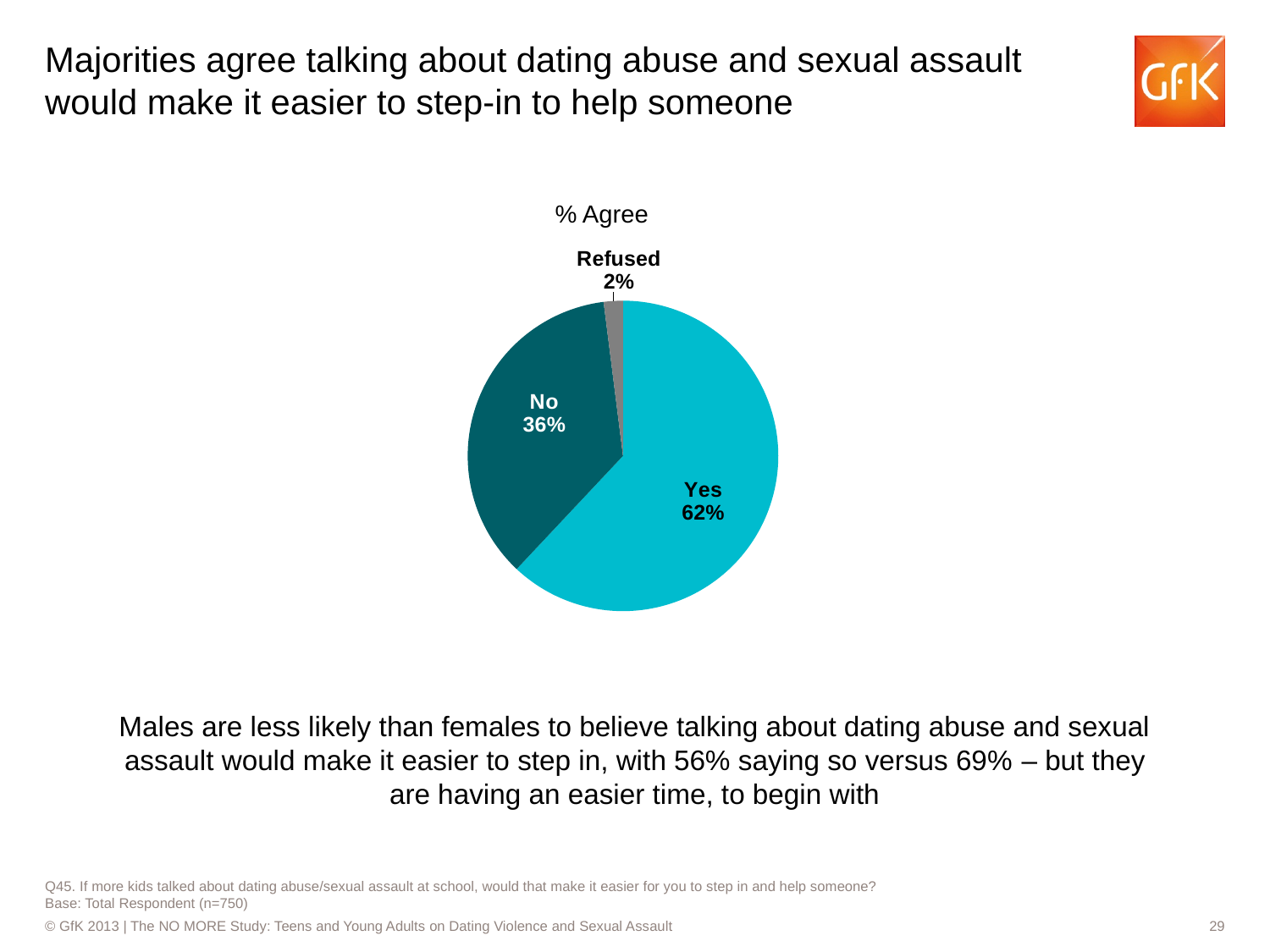
What percentage of respondents answered No? 36% What kind of chart is shown on the slide? pie chart What is the difference in percentage points between the No and Refused slices? 34 Which slice is larger, No or Refused? No What share of the pie does the Yes slice represent? 62% Which response has the largest share of the pie? Yes What percentage of respondents answered Yes? 62% How many slices does the pie chart have? 3 Which response has the smallest share of the pie? Refused What percentage of respondents Refused? 2% What is the title of the pie chart? % Agree What is the difference in percentage points between the Yes and No slices? 26